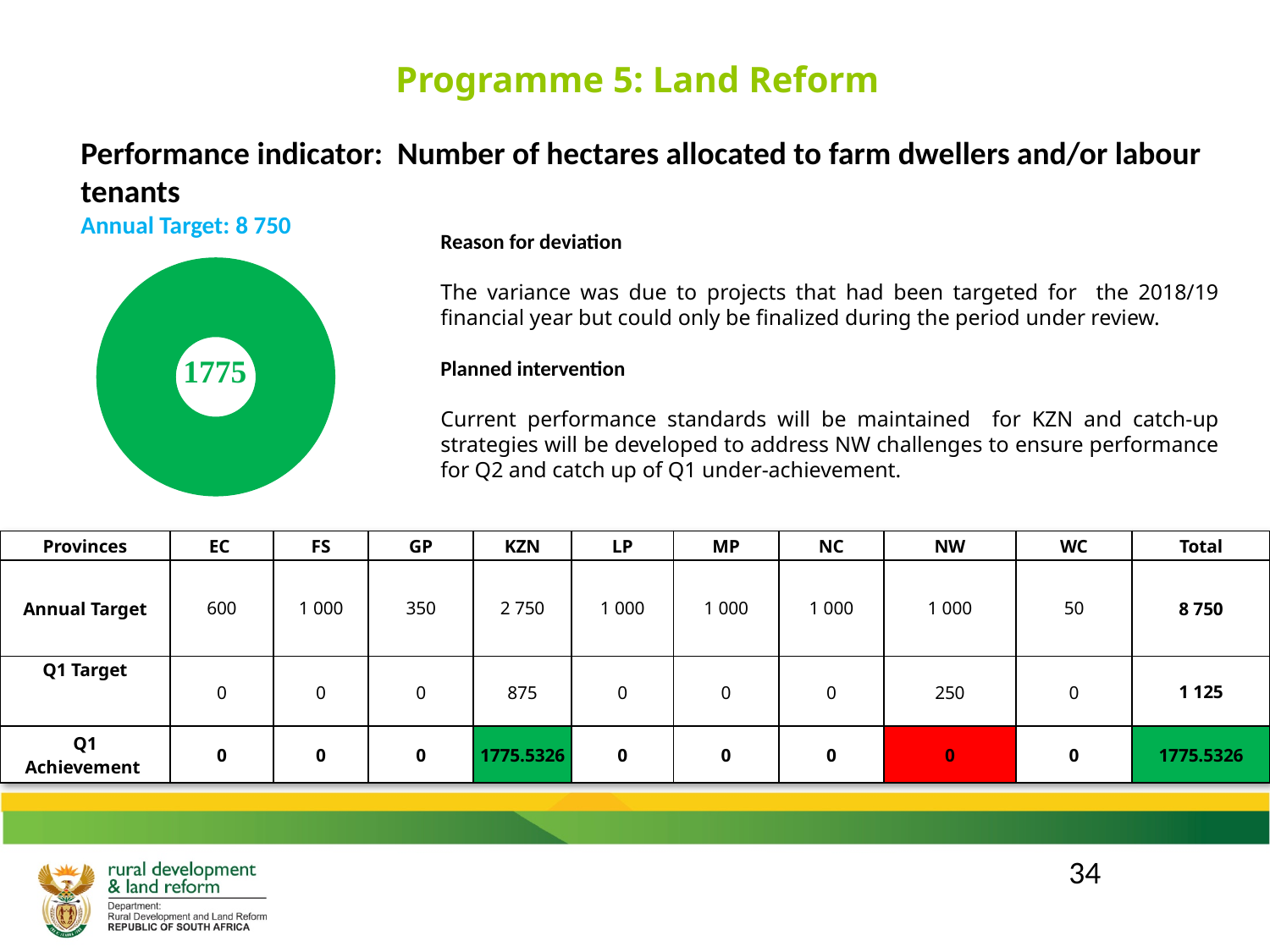
How many distinct slices are visible in the doughnut chart? 1 What kind of chart is shown on the slide? doughnut chart What value is printed in the centre of the doughnut chart? 1775 What colour is the ring of the doughnut chart? green Does the doughnut chart display a legend? No